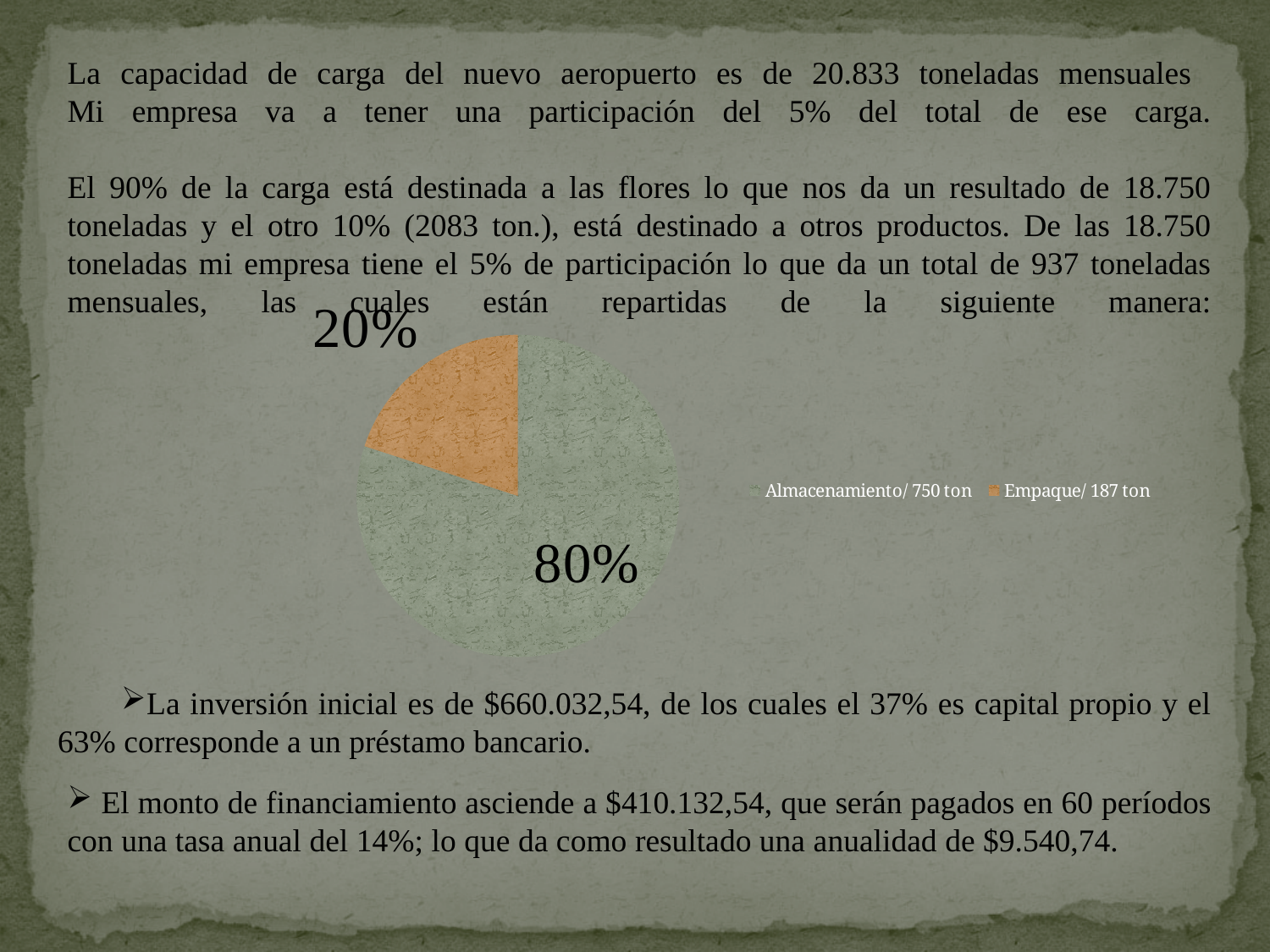
How many entries does the pie chart's legend list? 2 What percentage of the pie does the Almacenamiento/ 750 ton slice represent? 80% What is the difference in percentage points between the Almacenamiento/ 750 ton slice and the Empaque/ 187 ton slice? 60 percentage points What percentage of the pie does the Empaque/ 187 ton slice represent? 20% Which slice of the pie chart is the smallest? Empaque/ 187 ton Which slice of the pie chart is the largest? Almacenamiento/ 750 ton What colour is the Empaque/ 187 ton slice in the pie chart? orange Which is larger in the pie chart, the Almacenamiento/ 750 ton slice or the Empaque/ 187 ton slice? Almacenamiento/ 750 ton How many slices does the pie chart have? 2 What colour is the Almacenamiento/ 750 ton slice in the pie chart? green What kind of chart is shown on the slide? pie chart